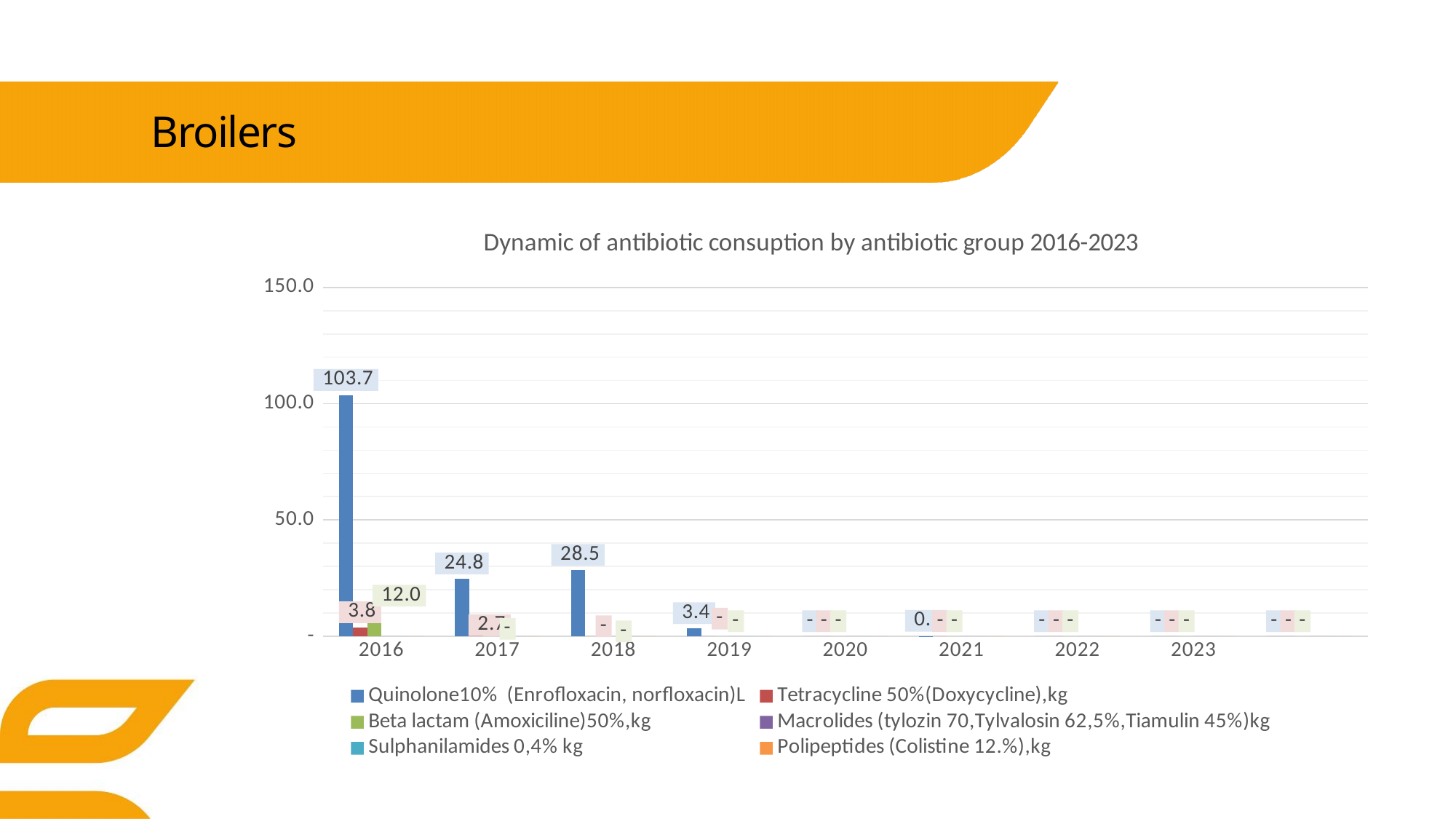
What is the value for Beta lactam (Amoxiciline)50%,kg in 2016? 12.0 What is the value for Quinolone10% (Enrofloxacin, norfloxacin)L in 2018? 28.5 How many years are shown on the x axis? 8 What is the difference between the Quinolone10% (Enrofloxacin, norfloxacin)L values in 2018 and 2017? 3.7 How many series does the legend list? 6 What is the value for Tetracycline 50%(Doxycycline),kg in 2016? 3.8 What is the value for Quinolone10% (Enrofloxacin, norfloxacin)L in 2019? 3.4 Which year has the larger Quinolone10% (Enrofloxacin, norfloxacin)L value, 2017 or 2018? 2018 What is the value for Quinolone10% (Enrofloxacin, norfloxacin)L in 2016? 103.7 What kind of chart is shown on the slide? bar chart What is the value for Quinolone10% (Enrofloxacin, norfloxacin)L in 2017? 24.8 In which year is the Quinolone10% (Enrofloxacin, norfloxacin)L value highest? 2016